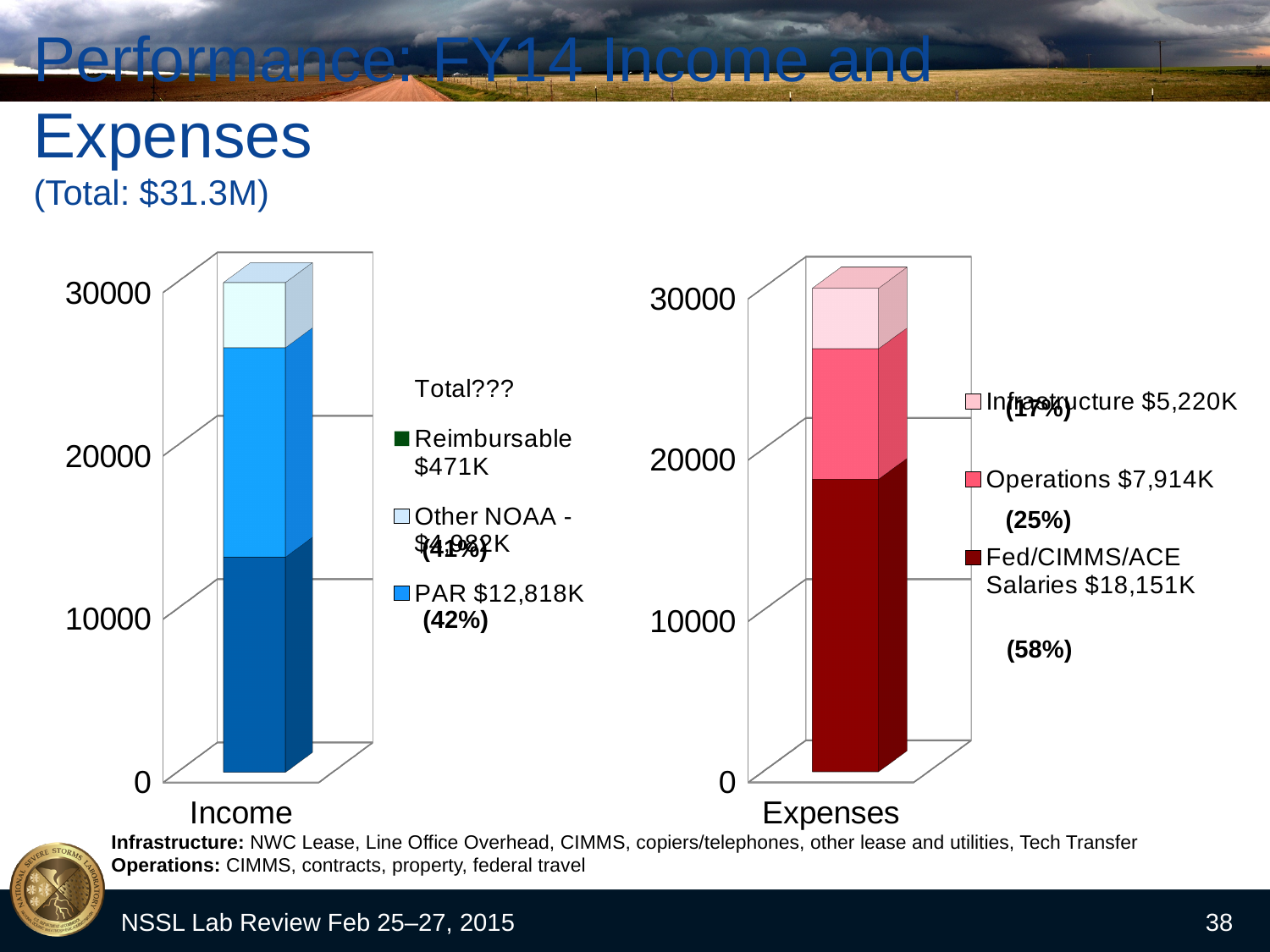
On the Expenses chart, what percentage share is shown for Fed/CIMMS/ACE Salaries? 58% On the Expenses chart, what is the difference between Fed/CIMMS/ACE Salaries and Operations? $10,237K What kind of chart is the Income chart? Stacked bar chart On the Expenses chart, which is larger, Operations or Infrastructure? Operations On the Expenses chart, which series has the smallest value? Infrastructure On the Expenses chart, what is the value for Infrastructure? $5,220K On the Expenses chart, which series has the largest value? Fed/CIMMS/ACE Salaries On the Expenses chart, what is the value for Fed/CIMMS/ACE Salaries? $18,151K How many series does the legend of the Expenses chart list? 3 On the Expenses chart, what is the total of the stacked Expenses bar? $31,285K On the Expenses chart, what is the value for Operations? $7,914K On the Income chart, what is the value for PAR? $12,818K